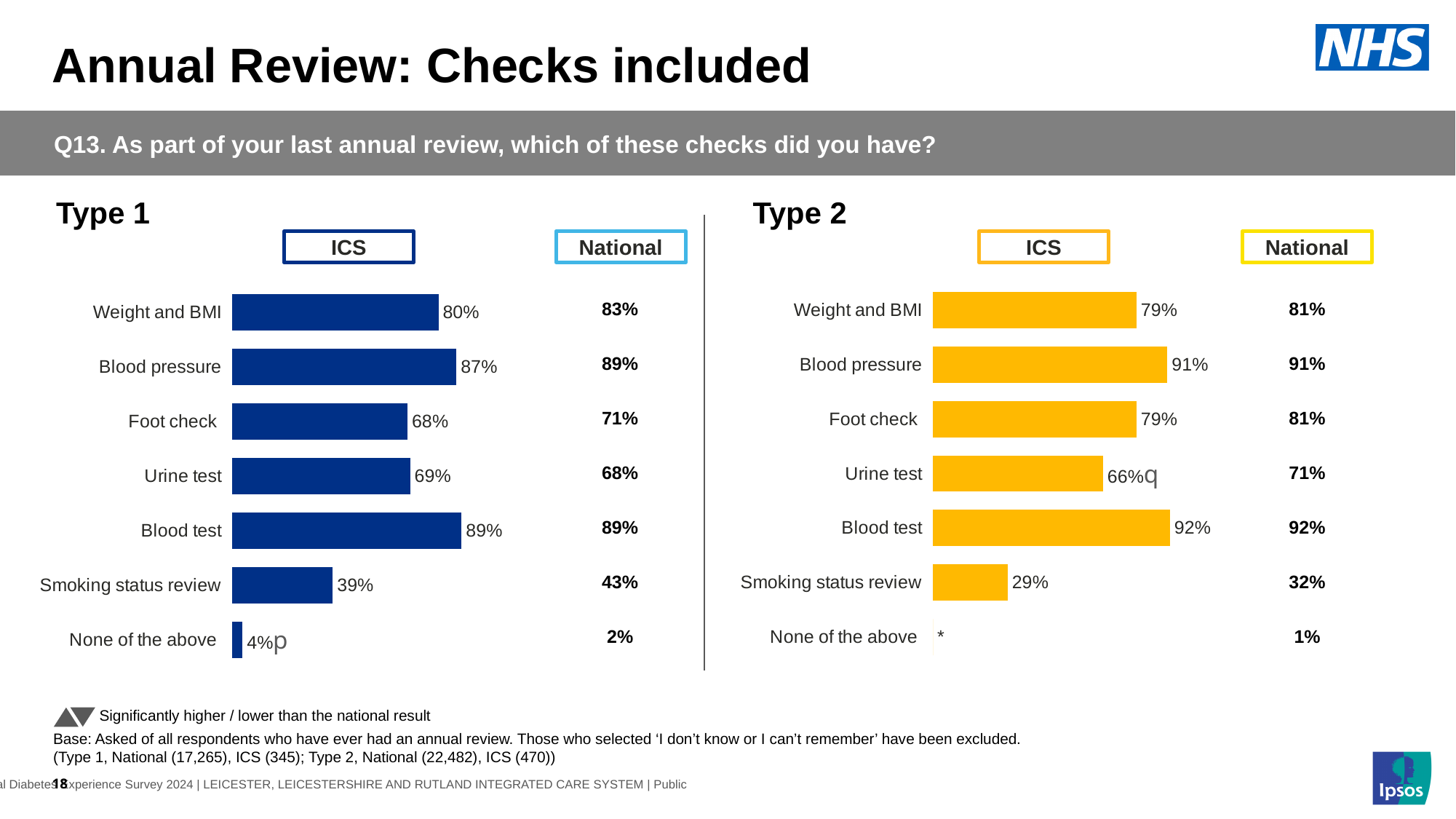
How many checks are listed in the Type 1 chart? 7 In the Type 1 chart, which check has the lowest ICS value? None of the above In the Type 2 chart, what is the difference between the National and ICS values for Urine test? 5 percentage points In the Type 1 chart, what is the difference between the National and ICS values for Smoking status review? 4 percentage points In the Type 1 chart, is the ICS value for Urine test higher or lower than the National value? higher In the Type 2 chart, which is larger: the ICS value for Weight and BMI or the ICS value for Urine test? Weight and BMI In the Type 2 chart, what is the ICS value for Smoking status review? 29% In the Type 1 chart, what is the National value for Foot check? 71% What type of chart is used for the Type 2 ICS results? Bar chart What colour are the ICS bars in the Type 2 chart? Yellow In the Type 1 chart, what is the ICS value for Blood pressure? 87% In the Type 2 chart, which check has the highest ICS value? Blood test